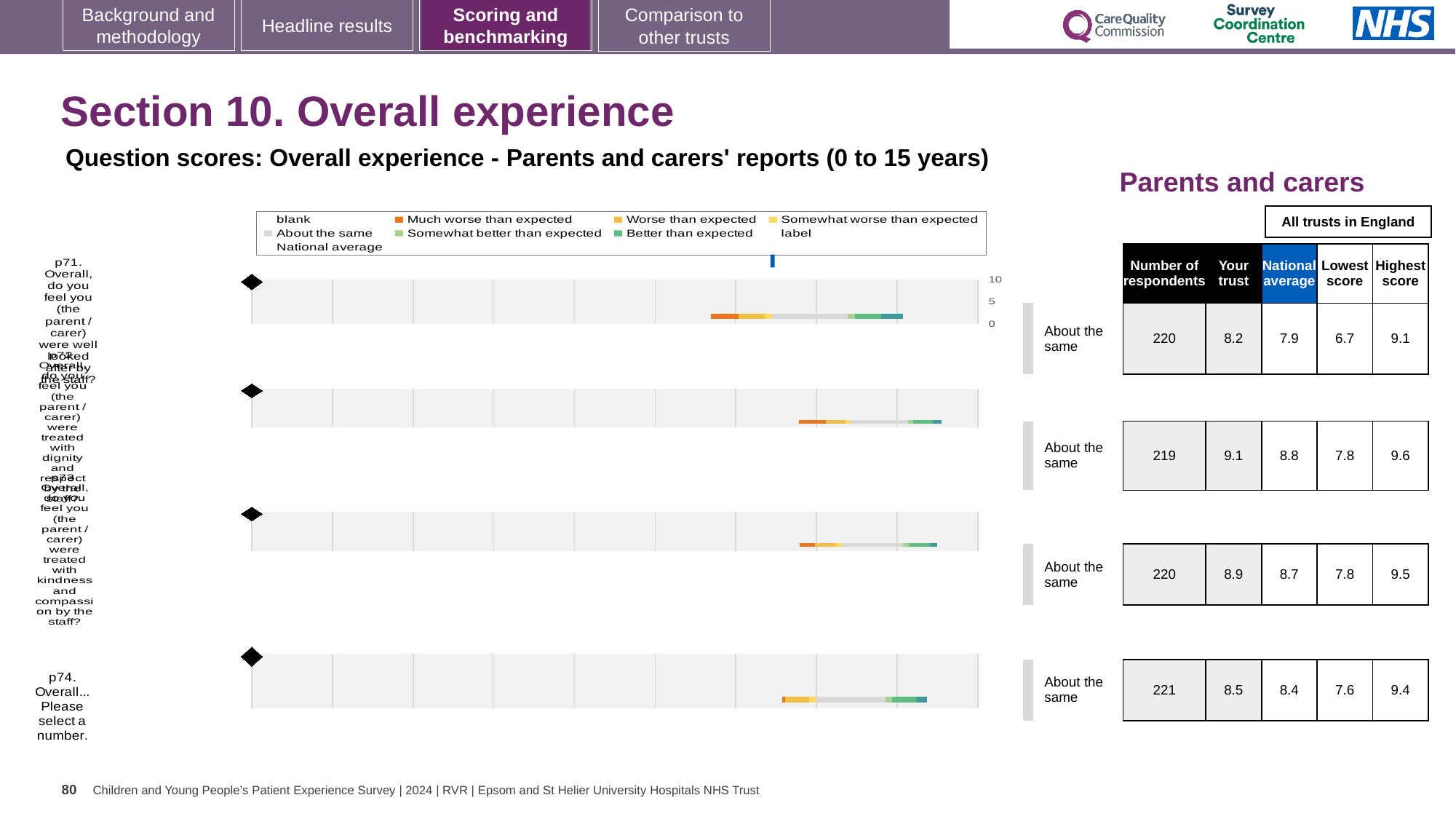
Which has the higher 'Your trust' score: the third row (p73) or the fourth row (p74)? p73 (third row) What benchmark category label is shown beside each of the four question rows? About the same What kind of chart is used to show the question scores on this slide? bar chart Which question row has the highest 'Your trust' score? p72 (second row), 9.1 What is the 'Your trust' score for the first question row (p71)? 8.2 How many entries does the chart legend list? 9 How many question rows (bars) are plotted in the chart? 4 For the first question row (p71), what is the difference between the 'Your trust' score and the national average? 0.3 Which question row has the lowest 'Lowest score' value? p71 (first row), 6.7 What is the national average score for the last question row (p74)? 8.4 How many respondents are shown for the second question row (p72)? 219